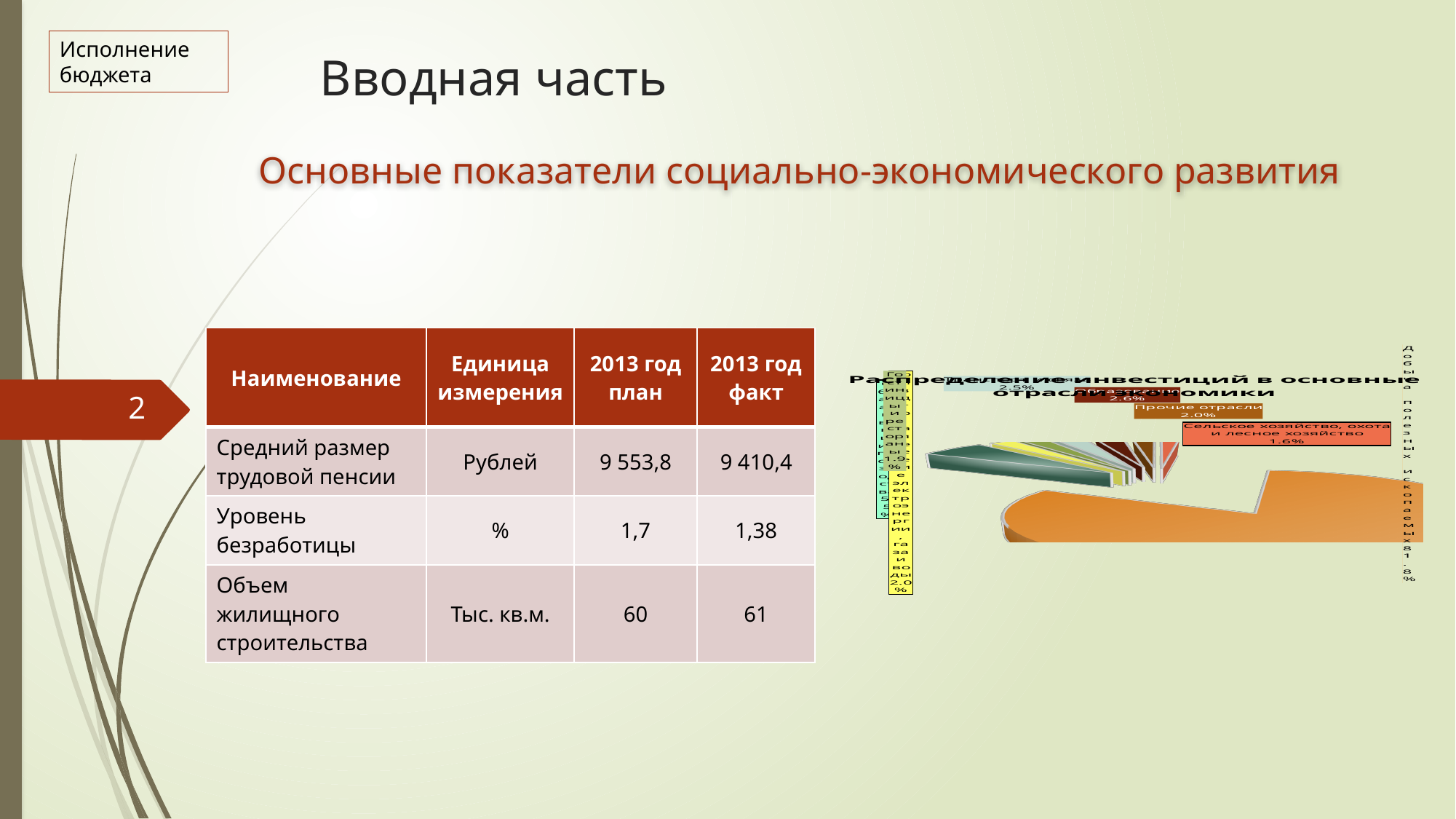
In the chart "Распределение инвестиций в основные отрасли экономики", what colour is the largest slice? Orange In the chart "Распределение инвестиций в основные отрасли экономики", which sector has the largest slice? Добыча полезных ископаемых In the chart "Распределение инвестиций в основные отрасли экономики", what share is labelled for "Добыча полезных ископаемых"? 81.8% In the chart "Распределение инвестиций в основные отрасли экономики", what share is labelled for "Прочие отрасли"? 2.0% In the chart "Распределение инвестиций в основные отрасли экономики", what share is labelled for "Сельское хозяйство, охота и лесное хозяйство"? 1.6% In the chart "Распределение инвестиций в основные отрасли экономики", which is larger: the share for "Прочие отрасли" or for "Сельское хозяйство, охота и лесное хозяйство"? Прочие отрасли What is the title of the chart on the right side of the slide? Распределение инвестиций в основные отрасли экономики In the chart "Распределение инвестиций в основные отрасли экономики", what is the difference between the shares for "Прочие отрасли" and "Сельское хозяйство, охота и лесное хозяйство"? 0.4% What kind of chart is shown on the right side of the slide? Pie chart